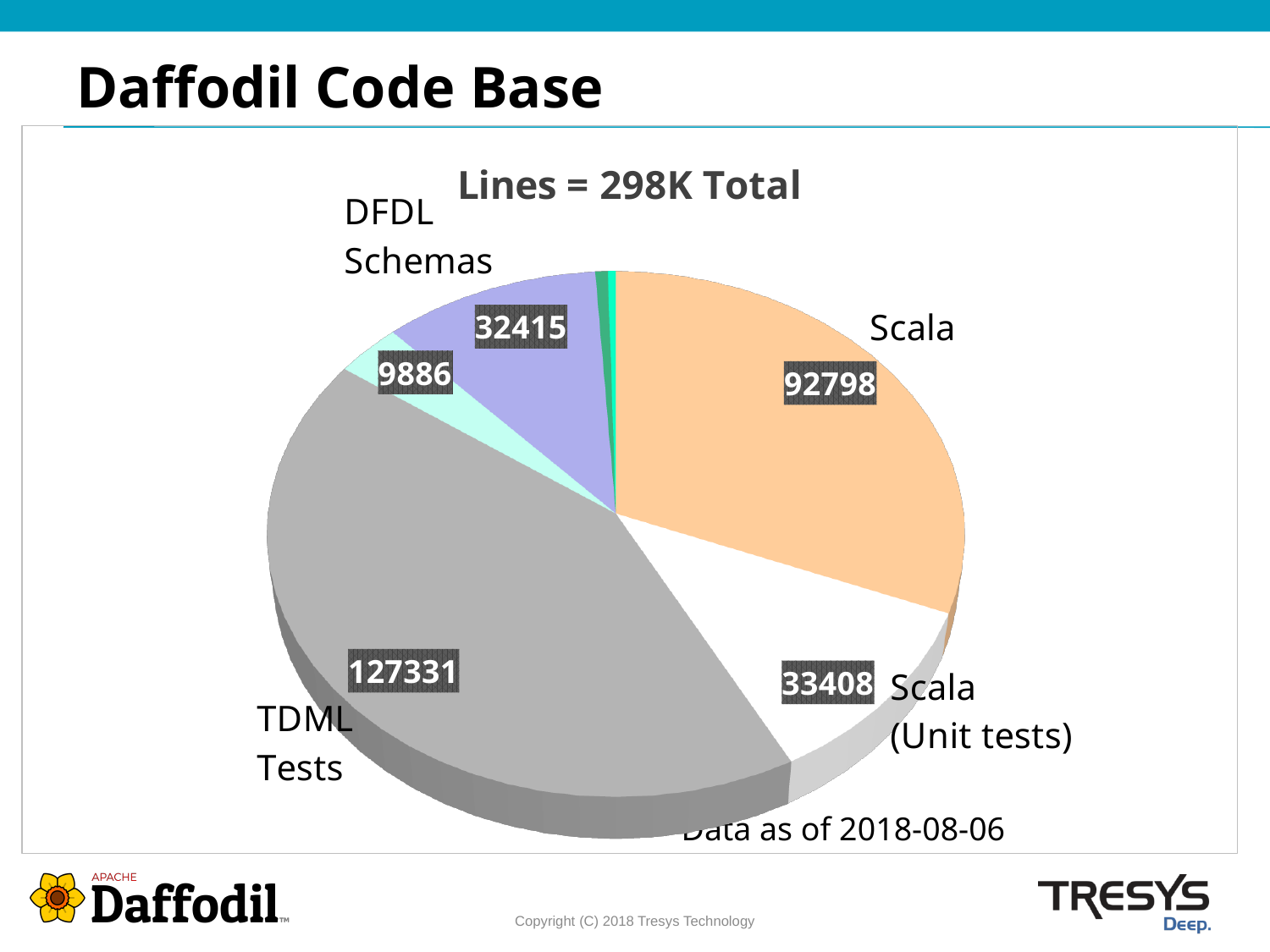
What is the value shown for the Scala slice? 92798 As of what date is the chart's data, according to the note on the slide? 2018-08-06 What kind of chart is shown on the slide? Pie chart Which is larger, the Scala slice or the Scala (Unit tests) slice? Scala What is the title of the chart? Lines = 298K Total What is the difference between the Scala value and the Scala (Unit tests) value? 59390 Which is larger, the TDML Tests slice or the DFDL Schemas slice? TDML Tests What is the difference between the TDML Tests value and the Scala value? 34533 Which labeled category has the largest slice of the pie? TDML Tests What is the value shown for the Scala (Unit tests) slice? 33408 What is the value shown for the TDML Tests slice? 127331